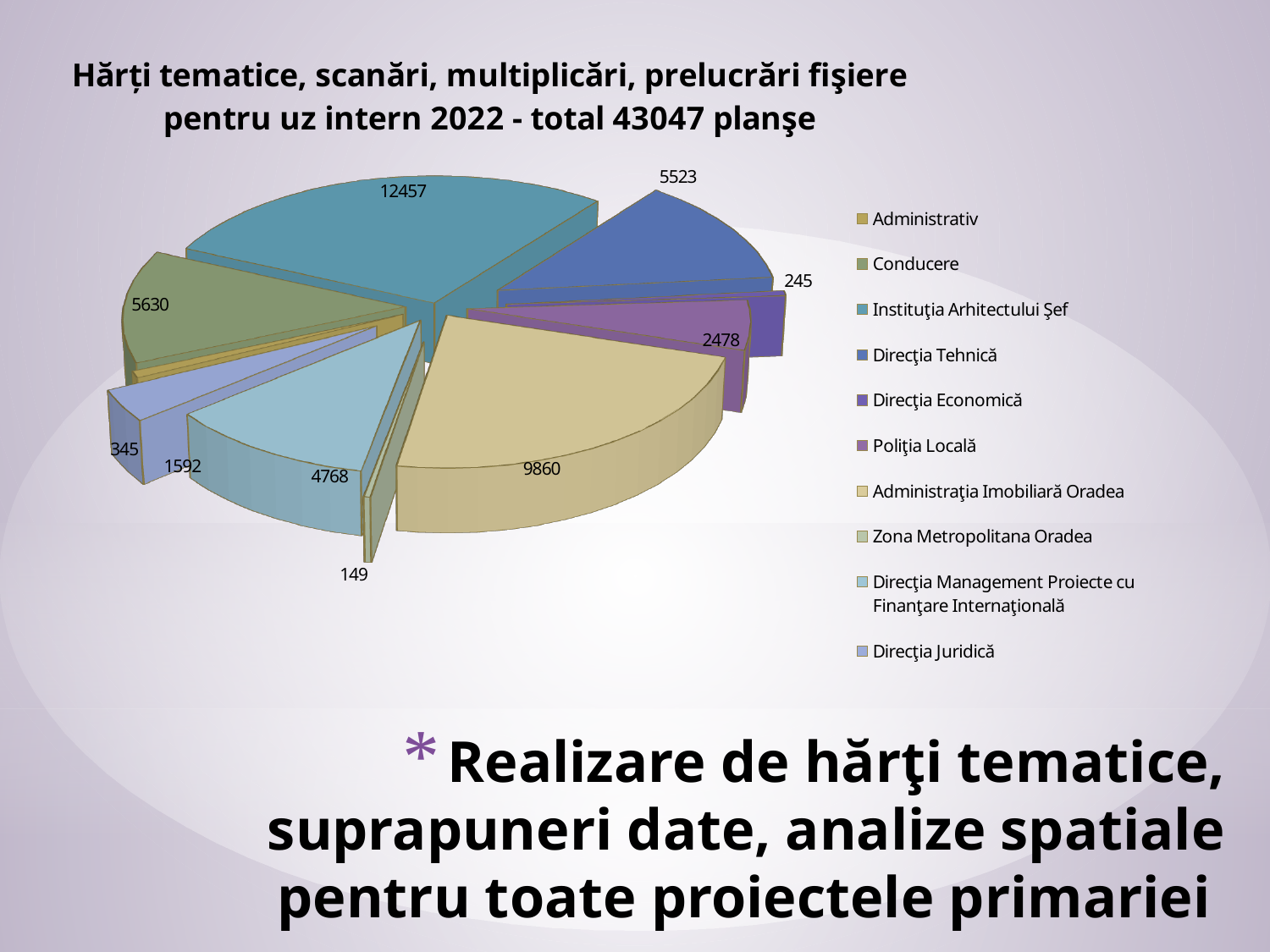
What is the value for Direcţia Management Proiecte cu Finanţare Internaţională in the pie chart? 4768 What is the value for Direcţia Tehnică in the pie chart? 5523 What total number of planşe does the chart title state for 2022? 43047 Which is larger, the value for Direcţia Tehnică or the value for Poliţia Locală? Direcţia Tehnică Which category has the largest slice in the pie chart? Instituţia Arhitectului Şef How many categories does the legend of the pie chart list? 10 Which category has the smallest slice in the pie chart? Zona Metropolitana Oradea What is the difference between the values for Instituţia Arhitectului Şef and Administraţia Imobiliară Oradea? 2597 What is the value for Zona Metropolitana Oradea in the pie chart? 149 What is the value for Instituţia Arhitectului Şef in the pie chart? 12457 What is the value for Administraţia Imobiliară Oradea in the pie chart? 9860 What type of chart is shown on the slide? Pie chart